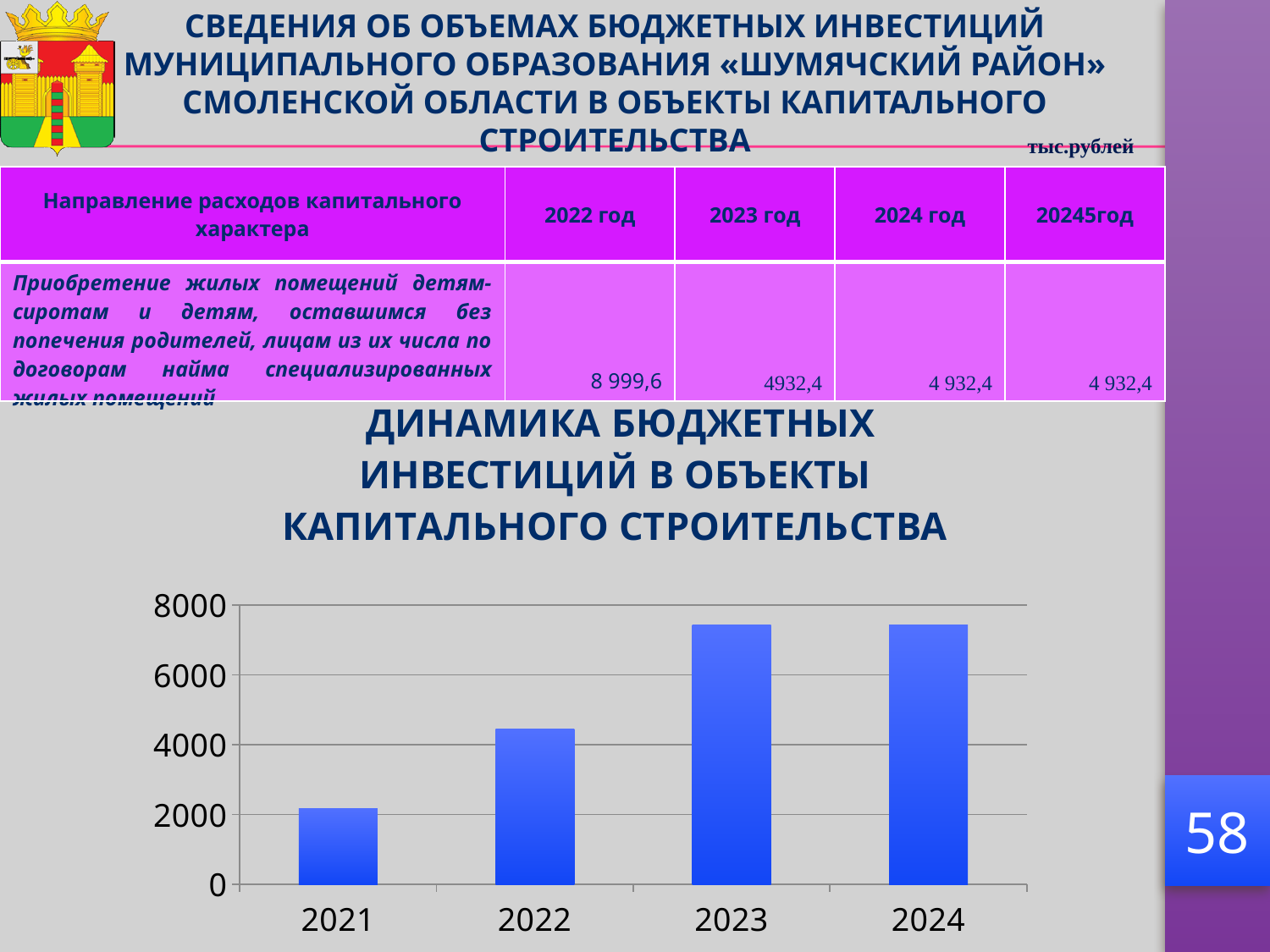
Do the values generally rise or fall from 2021 to 2024? rise How many years are shown on the x axis of the chart? 4 Is the value for 2022 greater or less than 6000? less Which is larger, the value for 2022 or the value for 2023? 2023 What is the highest value shown on the y axis of the chart? 8000 What kind of chart is shown on the slide? bar chart Which year has the lowest bar in the chart? 2021 Is the value for 2023 greater or less than 6000? greater What is the title of the chart? ДИНАМИКА БЮДЖЕТНЫХ ИНВЕСТИЦИЙ В ОБЪЕКТЫ КАПИТАЛЬНОГО СТРОИТЕЛЬСТВА Is the value for 2024 greater or less than 8000? less Which is larger, the value for 2021 or the value for 2022? 2022